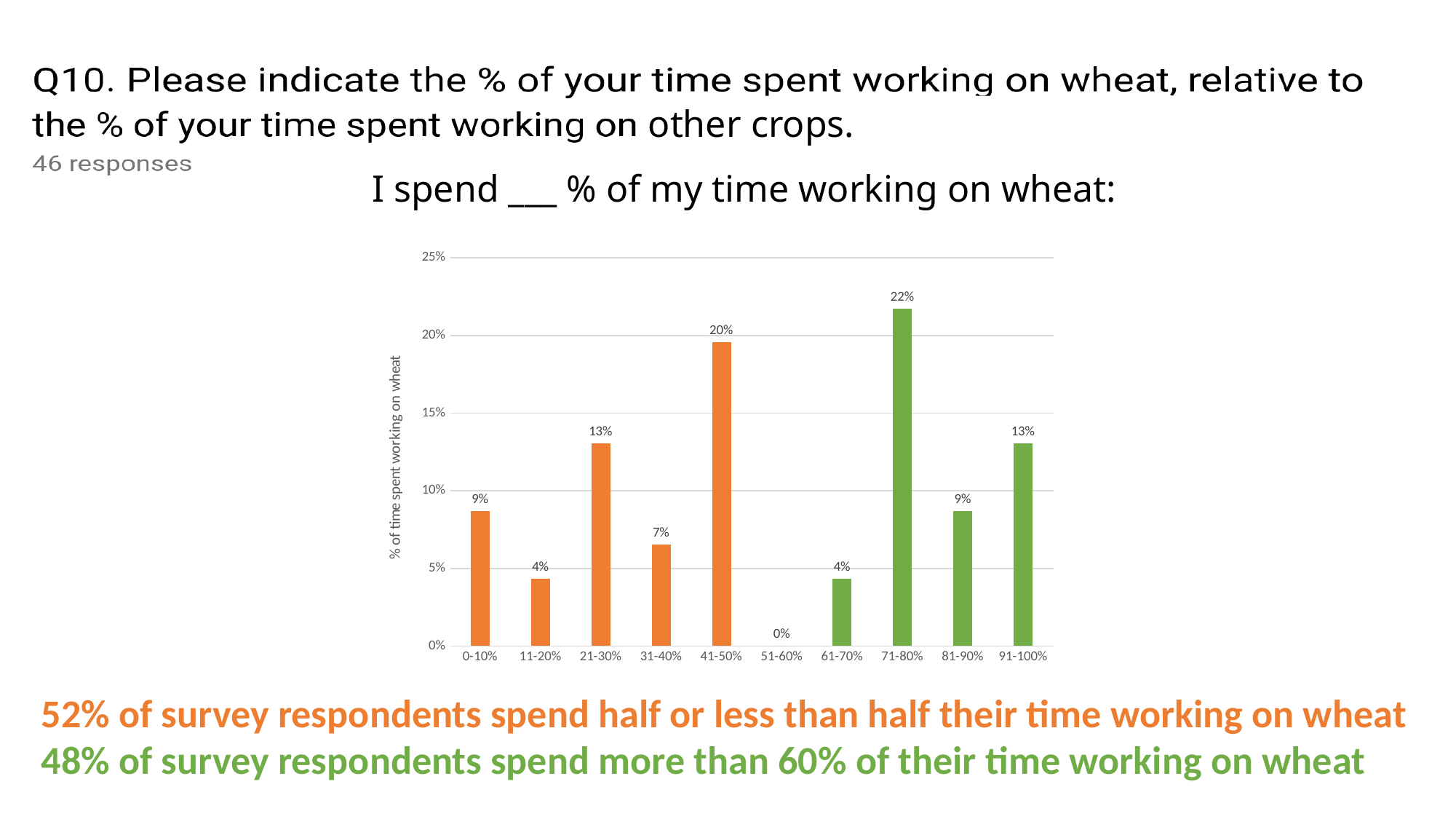
What kind of chart is shown on the slide? bar chart Which category has the lowest value? 51-60% What is the value for the 71-80% category? 22% What percentage of respondents spend 41-50% of their time working on wheat? 20% Which is larger, the value for 21-30% or the value for 31-40%? 21-30% Is the value for 0-10% greater or less than 10%? less What colour are the bars for the 61-70% through 91-100% categories? green Which category has the highest value? 71-80% How many categories are shown on the x axis? 10 What is the value for the 51-60% category? 0% What is the title of the chart? I spend ___ % of my time working on wheat: What is the difference between the values for 71-80% and 41-50%? 2%